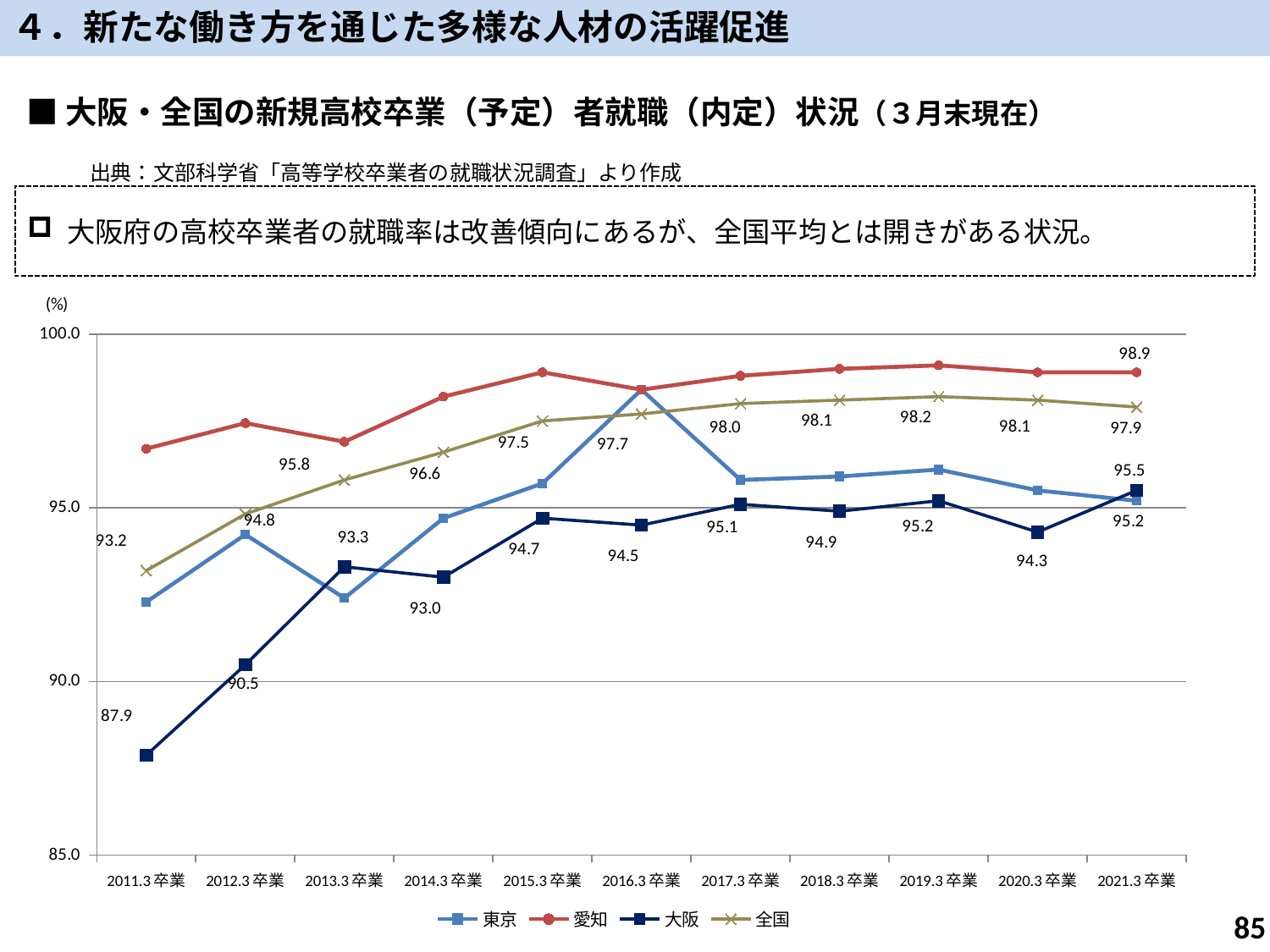
What is the difference between the 全国 and 大阪 values at 2021.3卒業? 2.4 What is the value for 東京 at 2021.3卒業? 95.2 What is the value for 全国 at 2019.3卒業? 98.2 What is the value for 大阪 at 2011.3卒業? 87.9 How many series does the legend list? 4 What kind of chart is shown on the slide? line chart Does the 大阪 series generally rise or fall from 2011.3卒業 to 2021.3卒業? rise What is the value for 愛知 at 2021.3卒業? 98.9 In which graduation year is the 大阪 value lowest? 2011.3卒業 Is the value for 東京 at 2011.3卒業 greater or less than 95.0? less How many graduation years are plotted along the x axis? 11 Which is larger at 2016.3卒業, the 全国 value or the 大阪 value? 全国